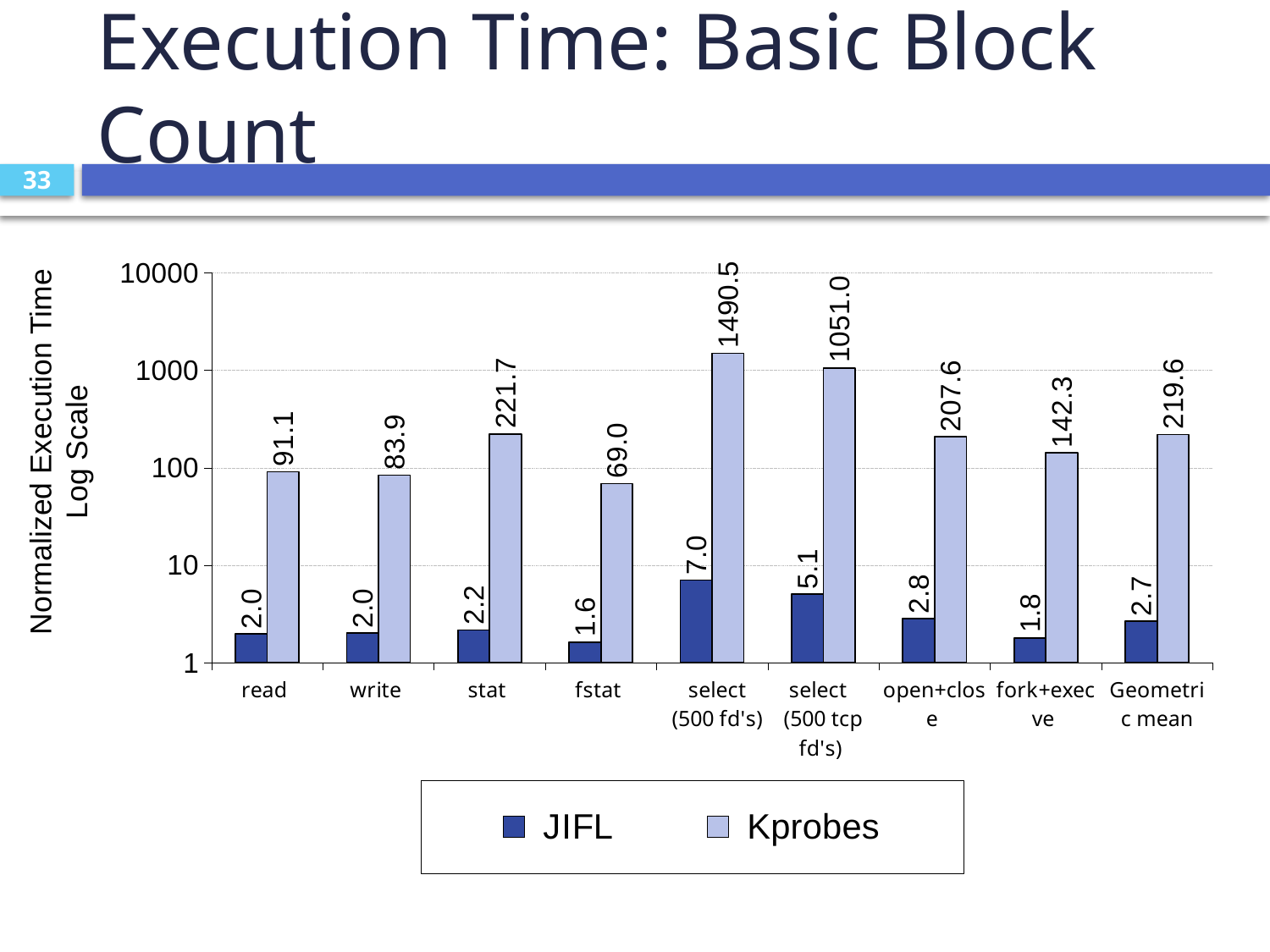
What kind of chart is shown on the slide? bar chart Which is larger, the Kprobes value for open+close or for fork+execve? open+close Which category has the lowest JIFL value? fstat What is the Kprobes value for stat? 221.7 What is the JIFL value for select (500 fd's)? 7.0 How many categories are shown on the x axis? 9 What is the y-axis label of the chart? Normalized Execution Time Log Scale How many series does the legend list? 2 What is the Kprobes value for the Geometric mean? 219.6 What is the difference between the Kprobes and JIFL values for read? 89.1 Which category has the highest Kprobes value? select (500 fd's) Is the Kprobes value for fstat greater or less than 100? less